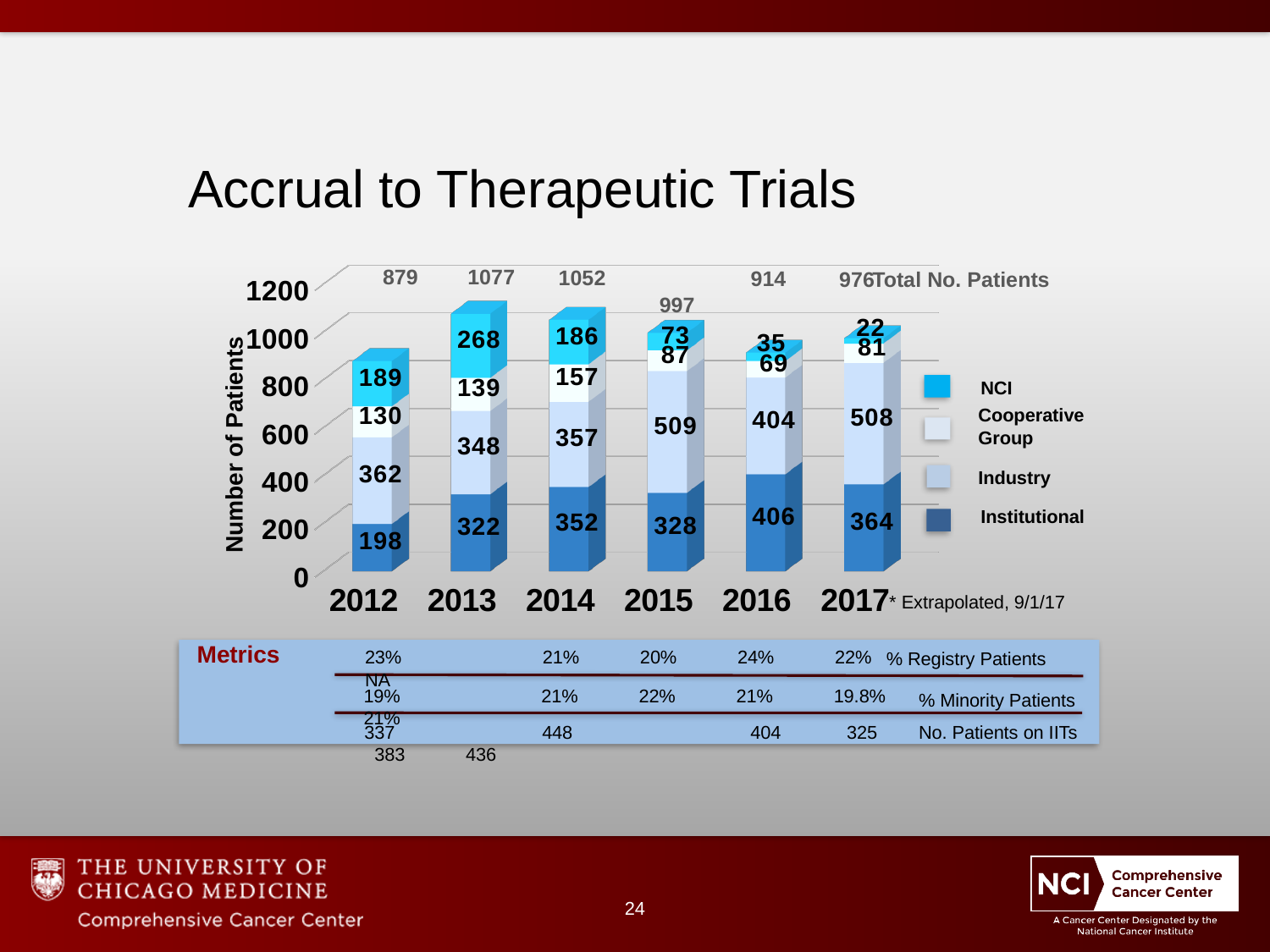
What is the Institutional value for 2016? 406 Which year has the lowest total number of patients? 2012 What is the NCI value for 2013? 268 What kind of chart is shown on the slide? Stacked bar chart What is the total number of patients for 2014? 1052 In 2015, which is larger: the Industry value or the Institutional value? Industry What is the title of the y axis? Number of Patients What is the difference between the NCI value in 2012 and the NCI value in 2017? 167 Does the NCI value rise or fall from 2013 to 2017? Fall How many series does the legend list? 4 How many years are shown on the x axis? 6 Which year has the highest total number of patients? 2013